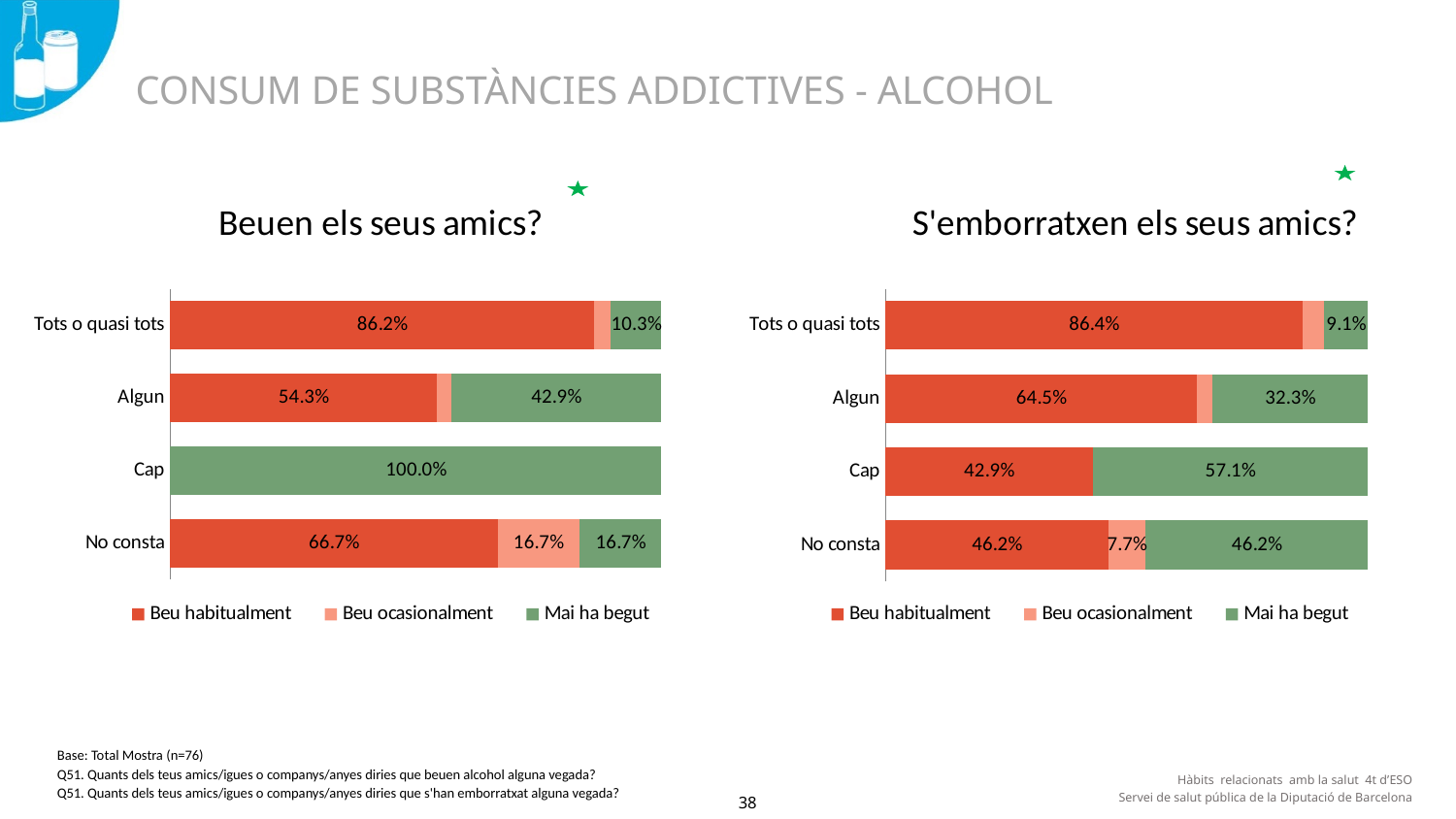
In the chart 'S'emborratxen els seus amics?', which category has the highest value for 'Beu habitualment'? Tots o quasi tots In the chart 'S'emborratxen els seus amics?', what is the value of 'Beu habitualment' for 'Algun'? 64.5% In the chart 'Beuen els seus amics?', what is the value of 'Beu habitualment' for 'Tots o quasi tots'? 86.2% In the chart 'Beuen els seus amics?', what is the value of 'Mai ha begut' for 'Algun'? 42.9% How many series does the legend of the chart 'Beuen els seus amics?' list? 3 In the chart 'Beuen els seus amics?', what is the value of 'Beu ocasionalment' for 'No consta'? 16.7% In the chart 'S'emborratxen els seus amics?', what is the value of 'Beu ocasionalment' for 'No consta'? 7.7% In the chart 'Beuen els seus amics?', what is the value of 'Mai ha begut' for 'Cap'? 100.0% In the chart 'Beuen els seus amics?', which is larger for 'Algun': 'Beu habitualment' or 'Mai ha begut'? Beu habitualment What kind of chart is 'S'emborratxen els seus amics?'? Stacked bar chart In the chart 'S'emborratxen els seus amics?', what is the difference between 'Mai ha begut' and 'Beu habitualment' for 'Cap'? 14.2% In the chart 'S'emborratxen els seus amics?', what is the value of 'Mai ha begut' for 'Cap'? 57.1%